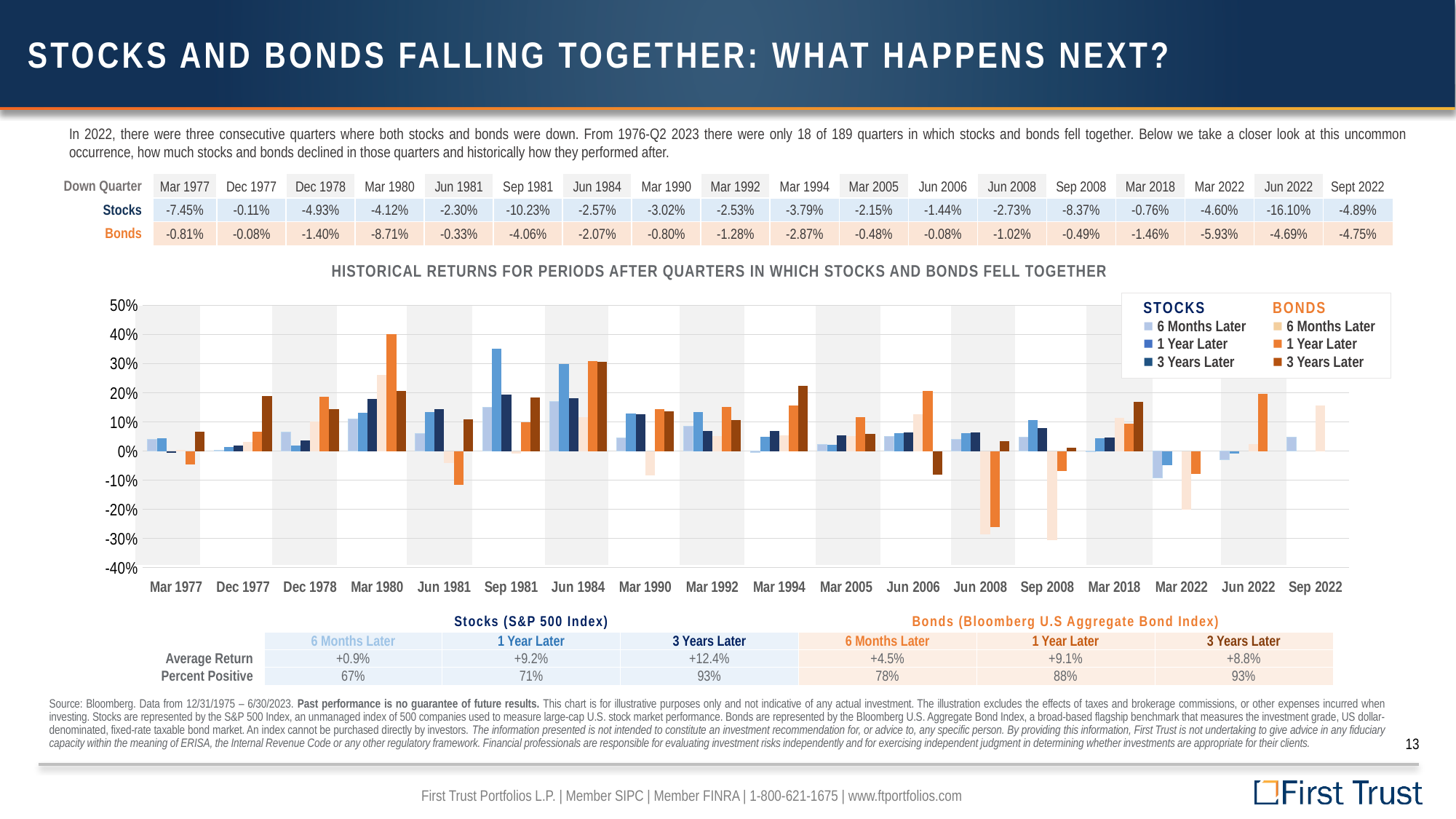
In the bar chart, is the Stocks 6 Months Later value for Sep 1981 greater or less than 30%? less In the bar chart, which is larger: the Bonds 1 Year Later value for Mar 1980 or for Jun 1984? Mar 1980 In the bar chart, is the Bonds 6 Months Later value for Sep 2008 greater or less than -20%? less What is the title of the bar chart? Historical Returns for Periods After Quarters in Which Stocks and Bonds Fell Together In the bar chart, is the Stocks 3 Years Later value for Mar 1980 greater or less than 10%? greater How many down quarters are shown along the x axis of the bar chart? 18 How many series does the legend of the bar chart list in total? 6 In the bar chart, which is larger: the Stocks 6 Months Later value for Sep 1981 or for Jun 1984? Jun 1984 What kind of chart is shown under the heading 'Historical Returns for Periods After Quarters in Which Stocks and Bonds Fell Together'? Bar chart In the bar chart, which down quarter has the tallest bar of any series? Mar 1980